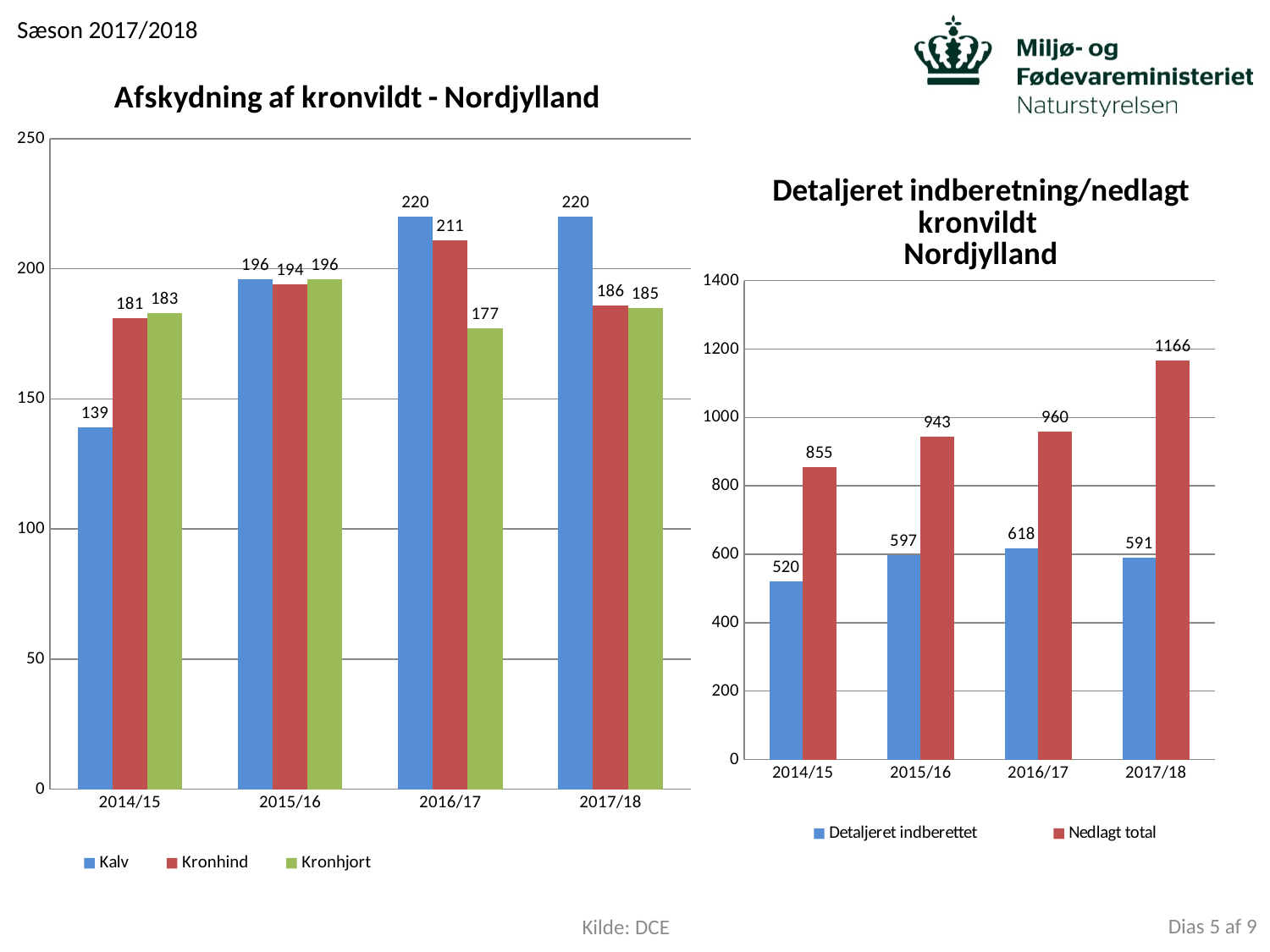
In the chart 'Detaljeret indberetning/nedlagt kronvildt Nordjylland', how many seasons are shown on the x axis? 4 In the chart 'Afskydning af kronvildt - Nordjylland', what is the difference between Kronhind and Kronhjort in 2017/18? 1 In the chart 'Detaljeret indberetning/nedlagt kronvildt Nordjylland', what is the difference between Nedlagt total and Detaljeret indberettet in 2014/15? 335 In the chart 'Afskydning af kronvildt - Nordjylland', how many series does the legend list? 3 In the chart 'Afskydning af kronvildt - Nordjylland', what is the value for Kalv in 2014/15? 139 In the chart 'Detaljeret indberetning/nedlagt kronvildt Nordjylland', what is the value for Nedlagt total in 2017/18? 1166 In the chart 'Detaljeret indberetning/nedlagt kronvildt Nordjylland', which season has the highest value for Nedlagt total? 2017/18 In the chart 'Afskydning af kronvildt - Nordjylland', what is the value for Kronhjort in 2016/17? 177 In the chart 'Detaljeret indberetning/nedlagt kronvildt Nordjylland', what is the value for Detaljeret indberettet in 2015/16? 597 What kind of chart is 'Detaljeret indberetning/nedlagt kronvildt Nordjylland'? Bar chart In the chart 'Afskydning af kronvildt - Nordjylland', which season has the lowest value for Kalv? 2014/15 In the chart 'Afskydning af kronvildt - Nordjylland', which is larger in 2016/17: Kalv or Kronhjort? Kalv